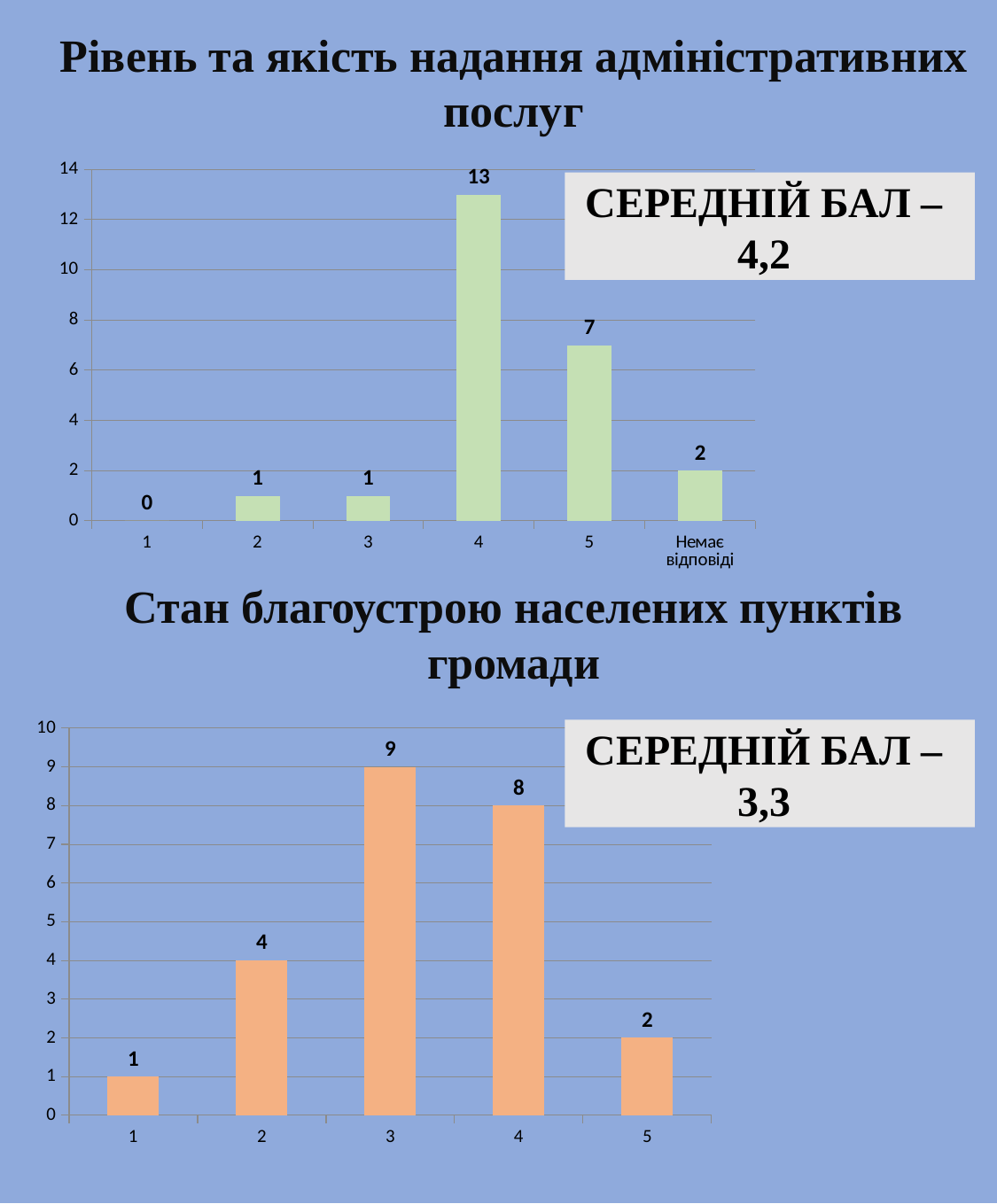
In the top chart (Рівень та якість надання адміністративних послуг), which category has the highest value? 4 In the top chart (Рівень та якість надання адміністративних послуг), what is the difference between the values for category 4 and category 5? 6 In the bottom chart (Стан благоустрою населених пунктів громади), what is the value for category 3? 9 In the bottom chart (Стан благоустрою населених пунктів громади), which is larger, the value for category 4 or category 5? 4 In the top chart (Рівень та якість надання адміністративних послуг), what is the value for category 4? 13 What kind of chart is the bottom chart (Стан благоустрою населених пунктів громади)? Bar chart In the bottom chart (Стан благоустрою населених пунктів громади), which category has the lowest value? 1 In the bottom chart (Стан благоустрою населених пунктів громади), what is the value for category 2? 4 In the top chart (Рівень та якість надання адміністративних послуг), which category has the lowest value? 1 In the top chart (Рівень та якість надання адміністративних послуг), how many categories are shown on the x axis? 6 In the bottom chart (Стан благоустрою населених пунктів громади), what is the difference between the values for category 3 and category 1? 8 In the top chart (Рівень та якість надання адміністративних послуг), what is the value for 'Немає відповіді'? 2